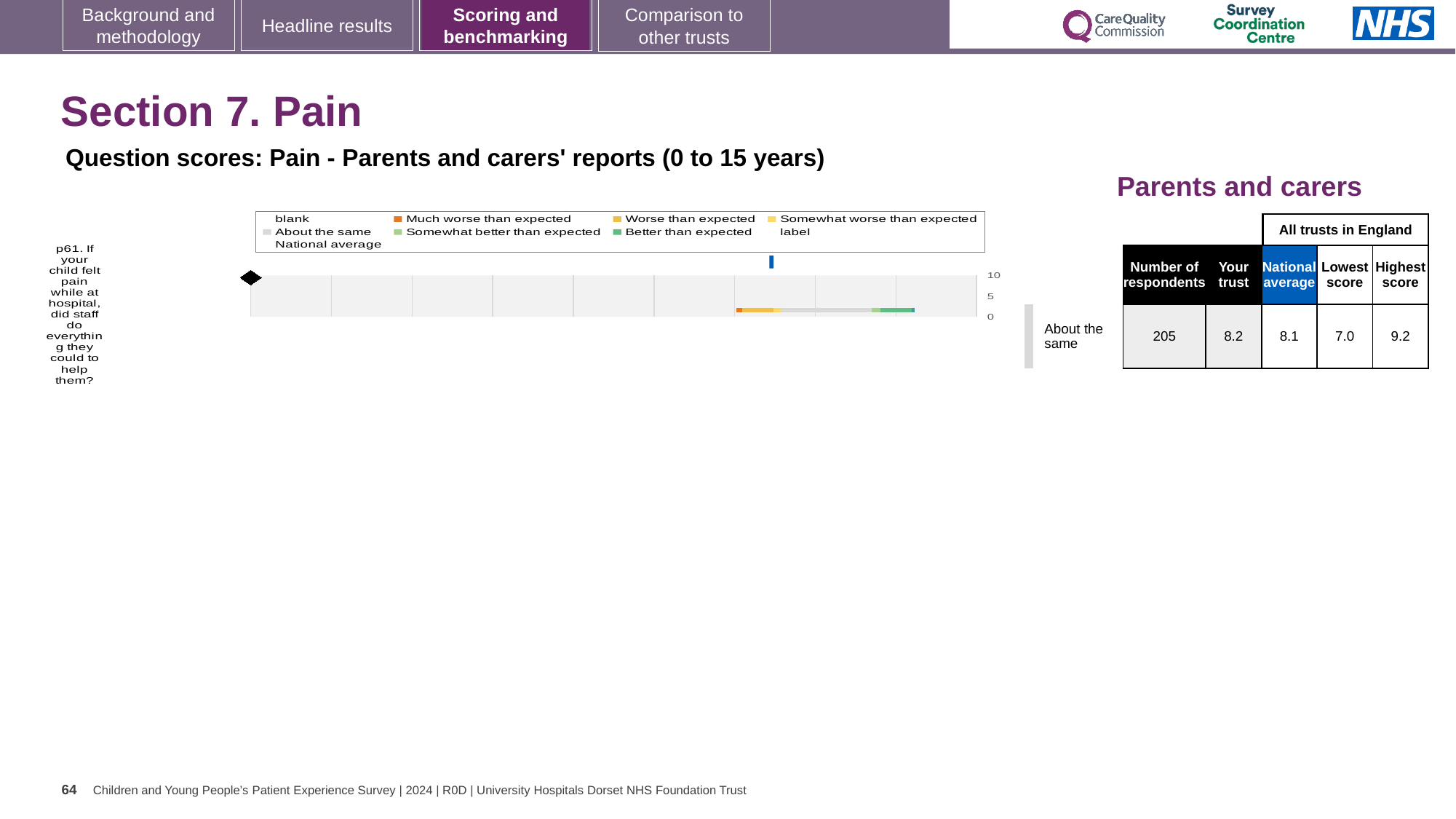
What is the difference between the Highest score and the Lowest score for question p61? 2.2 In the table next to the chart, what is the Number of respondents for question p61? 205 Which is larger for question p61, the Your trust score or the National average score? Your trust Is the national average marker on the chart greater or less than 5? greater In the table next to the chart, what is the Highest score among all trusts in England for question p61? 9.2 What is the highest value shown on the chart's axis? 10 In the table next to the chart, what is the Your trust score for question p61? 8.2 How many question categories are plotted on the chart? 1 What kind of chart is shown on the slide? bar chart Which legend entry is shown in blue on the chart? National average How many entries does the chart legend list? 9 In the table next to the chart, what is the National average score for question p61? 8.1